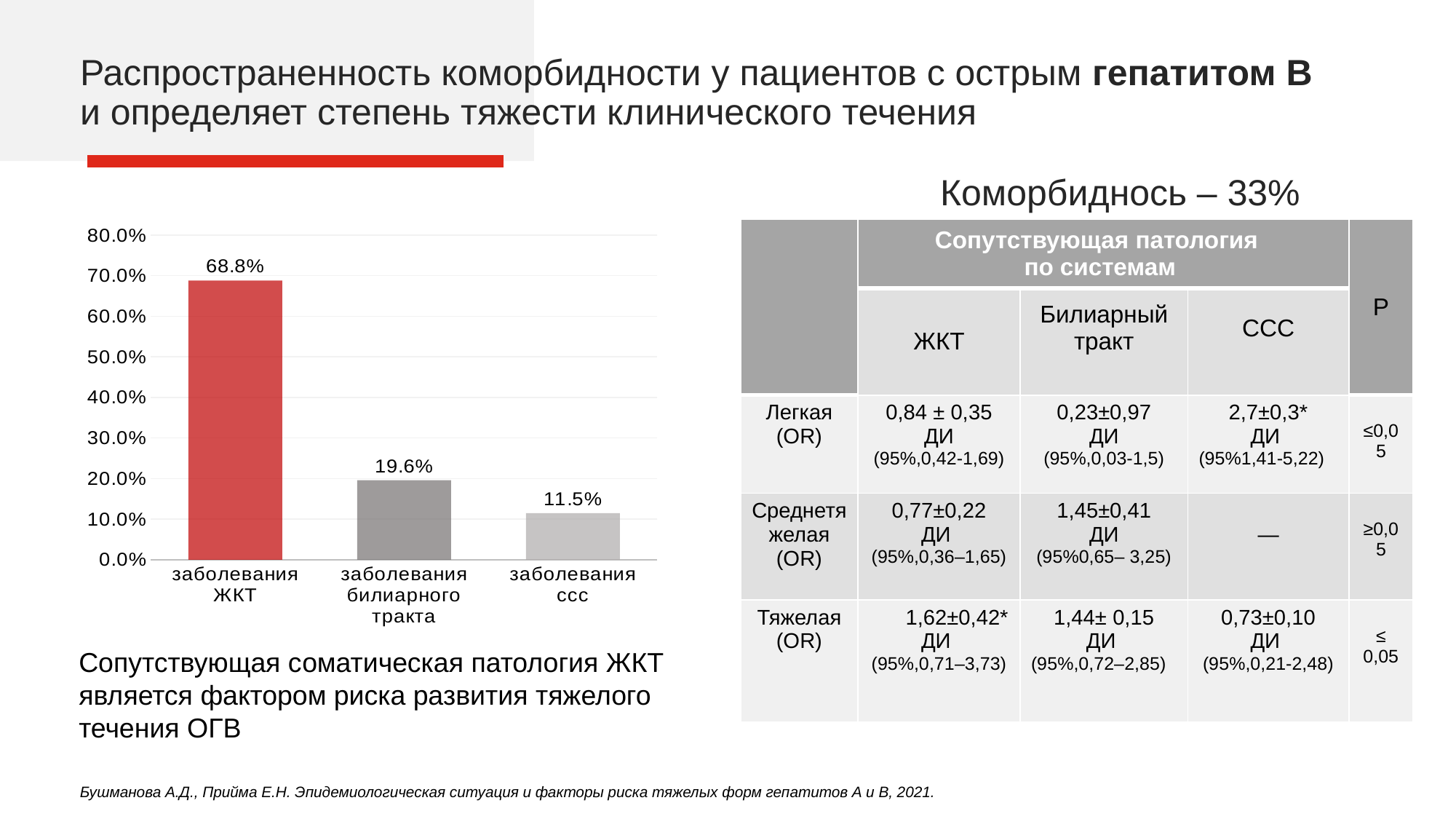
What is the difference between the values for заболевания билиарного тракта and заболевания ссс? 8.1% What is the value for заболевания ЖКТ in the bar chart? 68.8% Which category has the highest value in the bar chart? заболевания ЖКТ What is the difference between the values for заболевания ЖКТ and заболевания билиарного тракта? 49.2% Do the values in the bar chart rise or fall from left to right along the x axis? fall Which category has the lowest value in the bar chart? заболевания ссс Is the value for заболевания ЖКТ greater or less than 60.0%? greater Which is larger: the value for заболевания билиарного тракта or the value for заболевания ссс? заболевания билиарного тракта What is the value for заболевания билиарного тракта in the bar chart? 19.6% What kind of chart is shown on the left of the slide? bar chart How many categories are shown in the bar chart? 3 What is the value for заболевания ссс in the bar chart? 11.5%